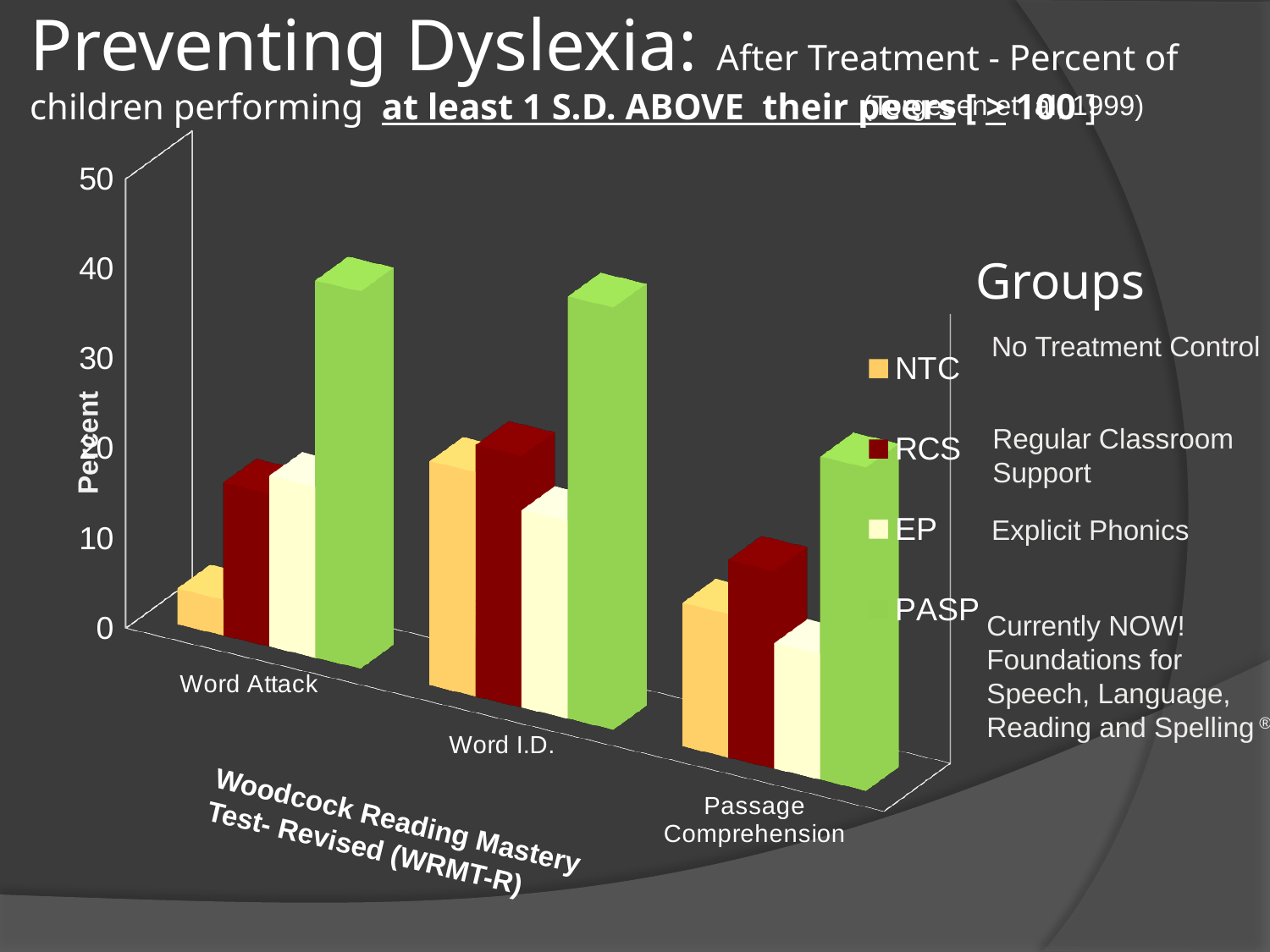
For Word I.D., which is larger: the value for PASP or the value for NTC? PASP Which group has the highest value for Passage Comprehension? PASP Which group has the lowest value for Word Attack? NTC Which group has the highest value for Word Attack? PASP How many groups does the chart legend list? 4 Is the value for PASP on Passage Comprehension greater or less than 10? greater Is the value for PASP on Word Attack greater or less than 30? greater What kind of chart is shown on the slide? bar chart Which group has the lowest value for Passage Comprehension? EP How many test categories are shown along the x axis of the chart? 3 Is the value for NTC on Word Attack greater or less than 10? less What is the label on the vertical axis of the chart? Percent